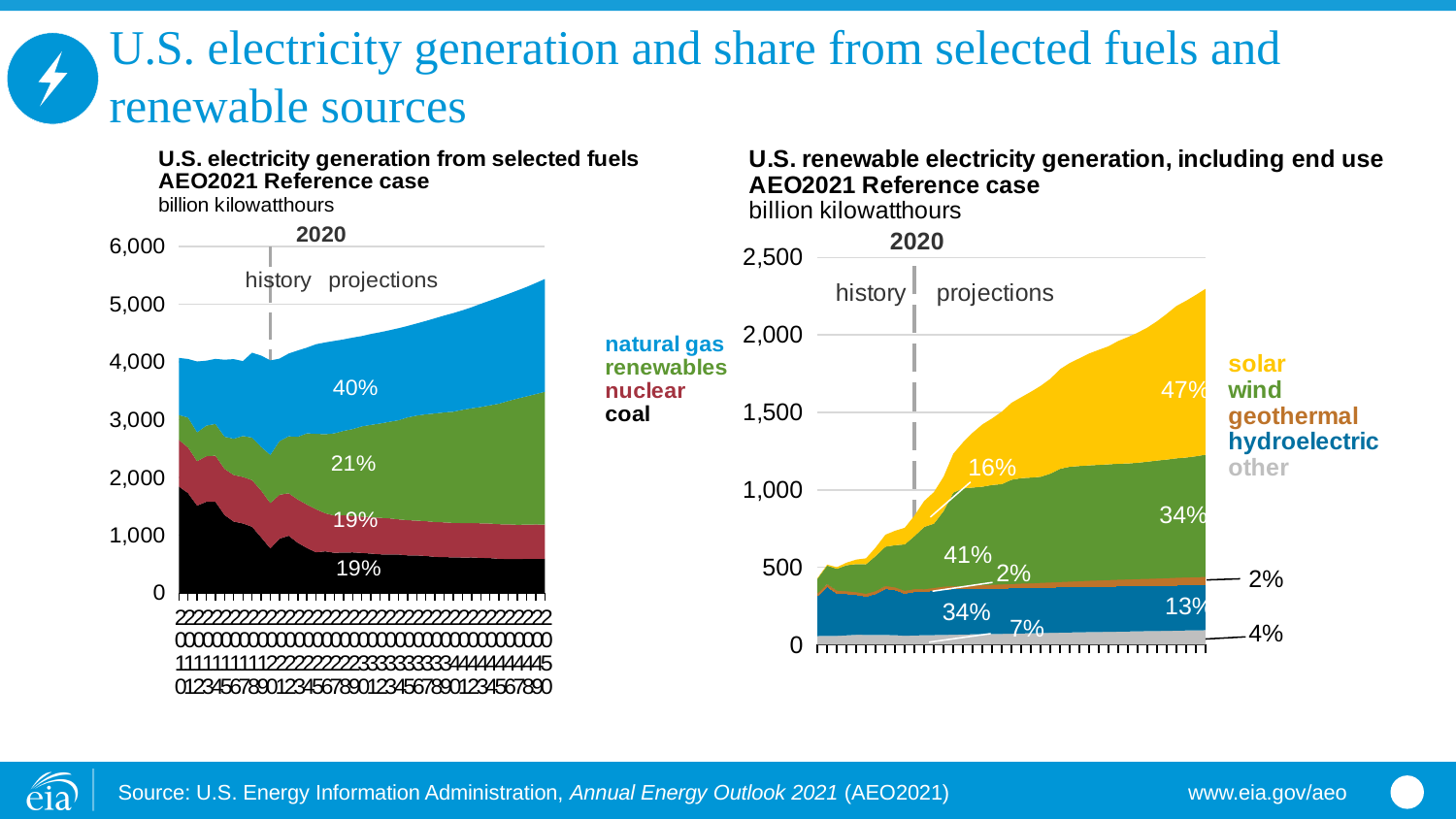
How many series does the legend of the left chart, 'U.S. electricity generation from selected fuels', list? 4 In the left chart, 'U.S. electricity generation from selected fuels', what share is labelled on the natural gas area? 40% In the left chart, 'U.S. electricity generation from selected fuels', what share is labelled on the renewables area? 21% In the right chart, 'U.S. renewable electricity generation, including end use', does total renewable generation rise or fall over the projection period? rise In the left chart, 'U.S. electricity generation from selected fuels', is the total generation at the right end of the projections greater or less than 5,000 billion kilowatthours? greater In the left chart, 'U.S. electricity generation from selected fuels', which fuel has the largest labelled share? natural gas In the right chart, 'U.S. renewable electricity generation, including end use', what share is labelled for hydroelectric at the right end of the projections? 13% In the right chart, 'U.S. renewable electricity generation, including end use', is total renewable generation at the right end of the projections greater or less than 2,000 billion kilowatthours? greater In the right chart, 'U.S. renewable electricity generation, including end use', what share is labelled for solar at the right end of the projections? 47% What kind of chart is the left chart, 'U.S. electricity generation from selected fuels'? stacked area chart In the right chart, 'U.S. renewable electricity generation, including end use', what share is labelled for wind near the 2020 line? 41% How many series does the legend of the right chart, 'U.S. renewable electricity generation, including end use', list? 5